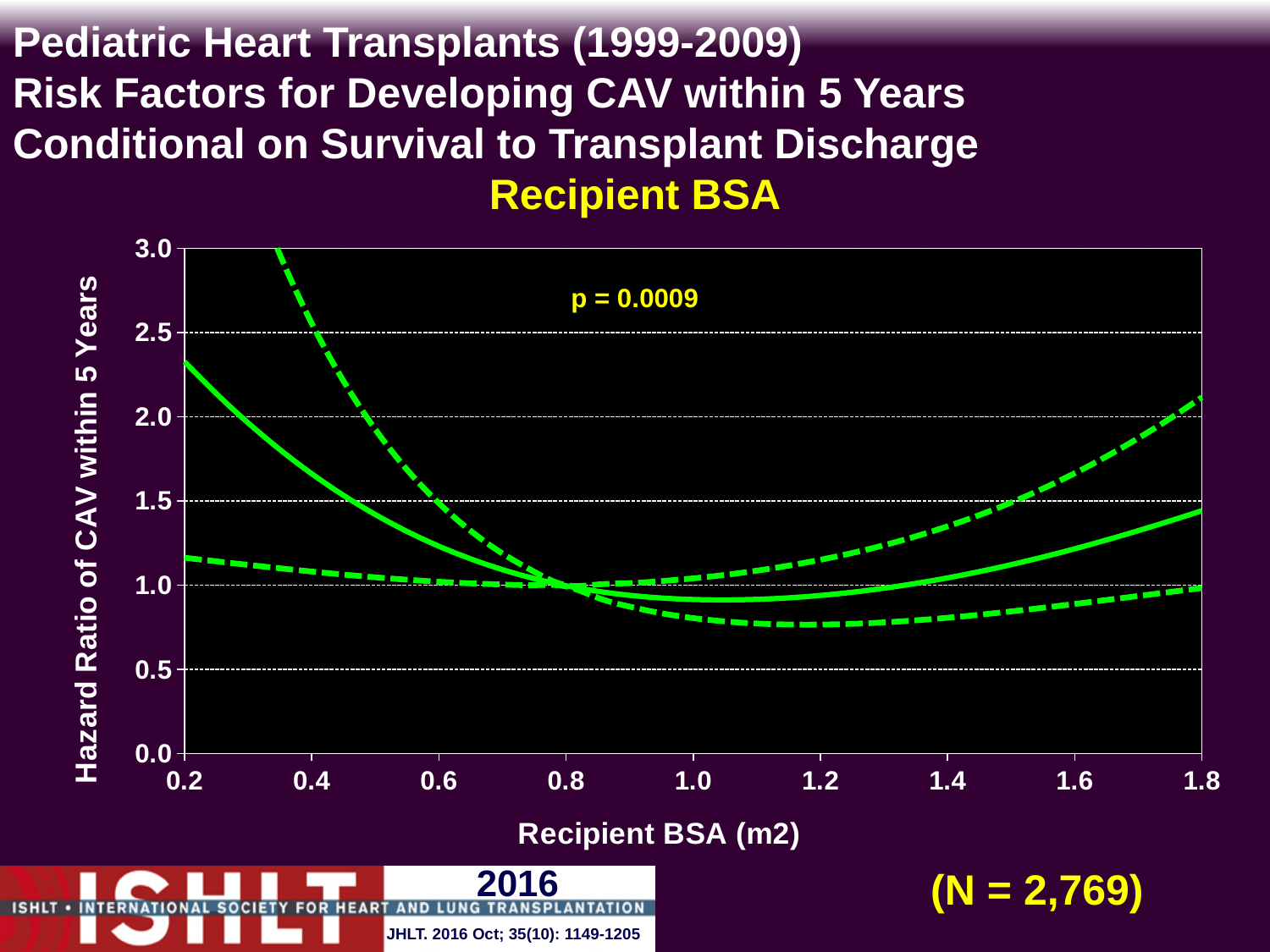
What is the sample size (N) shown on the slide? N = 2,769 Does the solid hazard ratio line rise or fall as recipient BSA increases from 0.2 to 0.8 m2? fall How many tick labels are shown on the x axis? 9 What is the maximum value shown on the y axis? 3.0 Is the hazard ratio of the solid line at a recipient BSA of 0.4 m2 greater or less than 1.5? greater Is the hazard ratio of the solid line at a recipient BSA of 1.8 m2 greater or less than 1.0? greater Does the solid hazard ratio line rise or fall as recipient BSA increases from 1.2 to 1.8 m2? rise Is the hazard ratio of the solid line at a recipient BSA of 0.2 m2 greater or less than 2.0? greater What is the p-value printed on the chart? p = 0.0009 What kind of chart is shown on the slide? Line chart Is the hazard ratio of the solid line higher at a recipient BSA of 0.2 m2 or at 1.8 m2? 0.2 m2